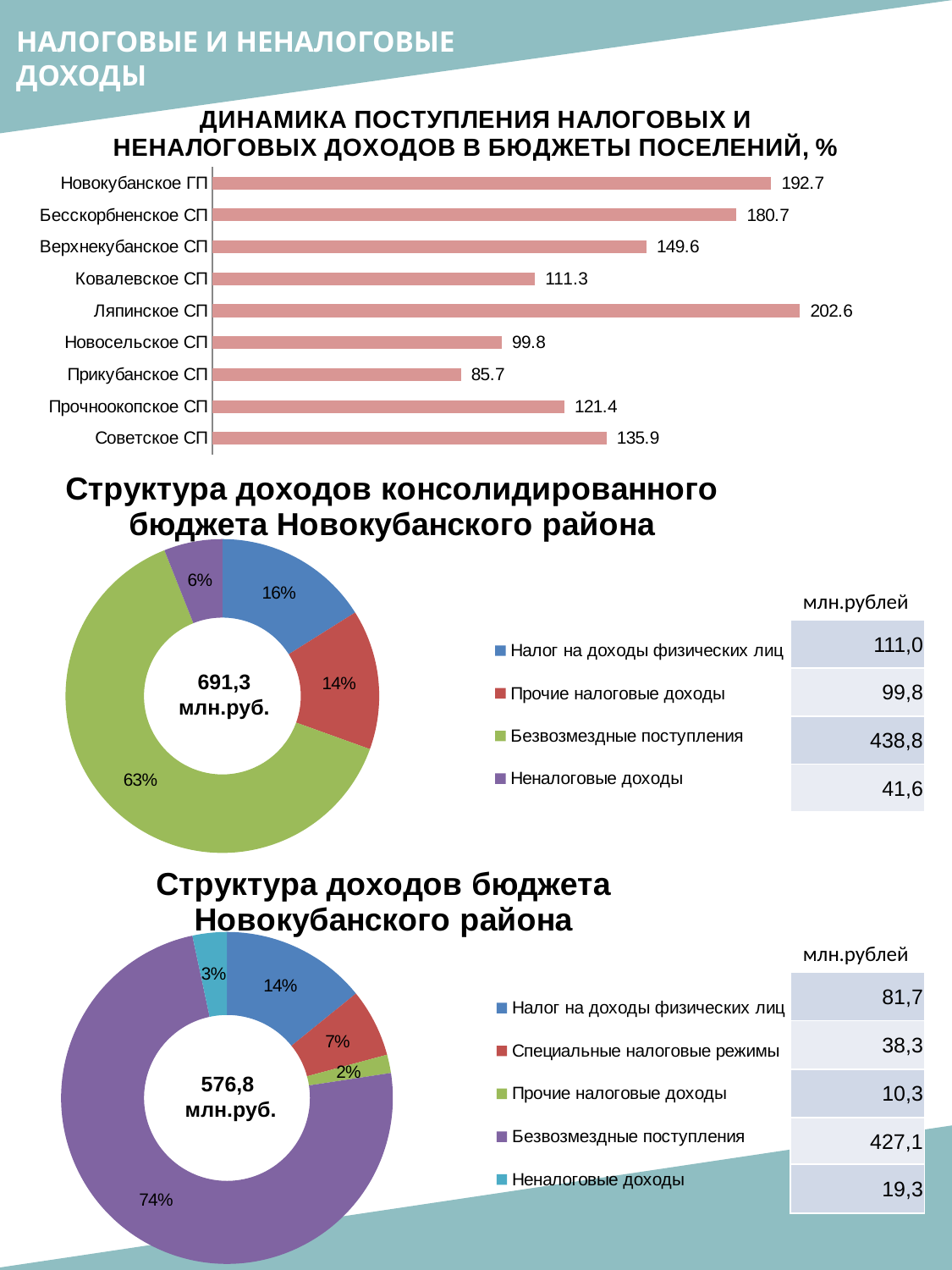
In the bar chart 'Динамика поступления налоговых и неналоговых доходов в бюджеты поселений, %', which settlement has the highest value? Ляпинское СП How many settlements are shown in the bar chart 'Динамика поступления налоговых и неналоговых доходов в бюджеты поселений, %'? 9 In the bar chart 'Динамика поступления налоговых и неналоговых доходов в бюджеты поселений, %', what is the value for Ляпинское СП? 202.6 In the bar chart 'Динамика поступления налоговых и неналоговых доходов в бюджеты поселений, %', which is larger: Ковалевское СП or Прочноокопское СП? Прочноокопское СП In the chart 'Структура доходов бюджета Новокубанского района', what is the value in млн.рублей for Специальные налоговые режимы? 38,3 In the chart 'Структура доходов консолидированного бюджета Новокубанского района', what is the value in млн.рублей for Неналоговые доходы? 41,6 In the bar chart 'Динамика поступления налоговых и неналоговых доходов в бюджеты поселений, %', which settlement has the lowest value? Прикубанское СП How many categories does the legend list in the chart 'Структура доходов бюджета Новокубанского района'? 5 In the chart 'Структура доходов консолидированного бюджета Новокубанского района', what share do Безвозмездные поступления make up? 63% What type of chart is 'Динамика поступления налоговых и неналоговых доходов в бюджеты поселений, %'? Bar chart In the bar chart 'Динамика поступления налоговых и неналоговых доходов в бюджеты поселений, %', what is the difference between Новокубанское ГП and Бесскорбненское СП? 12.0 In the chart 'Структура доходов бюджета Новокубанского района', which category has the smallest share? Прочие налоговые доходы